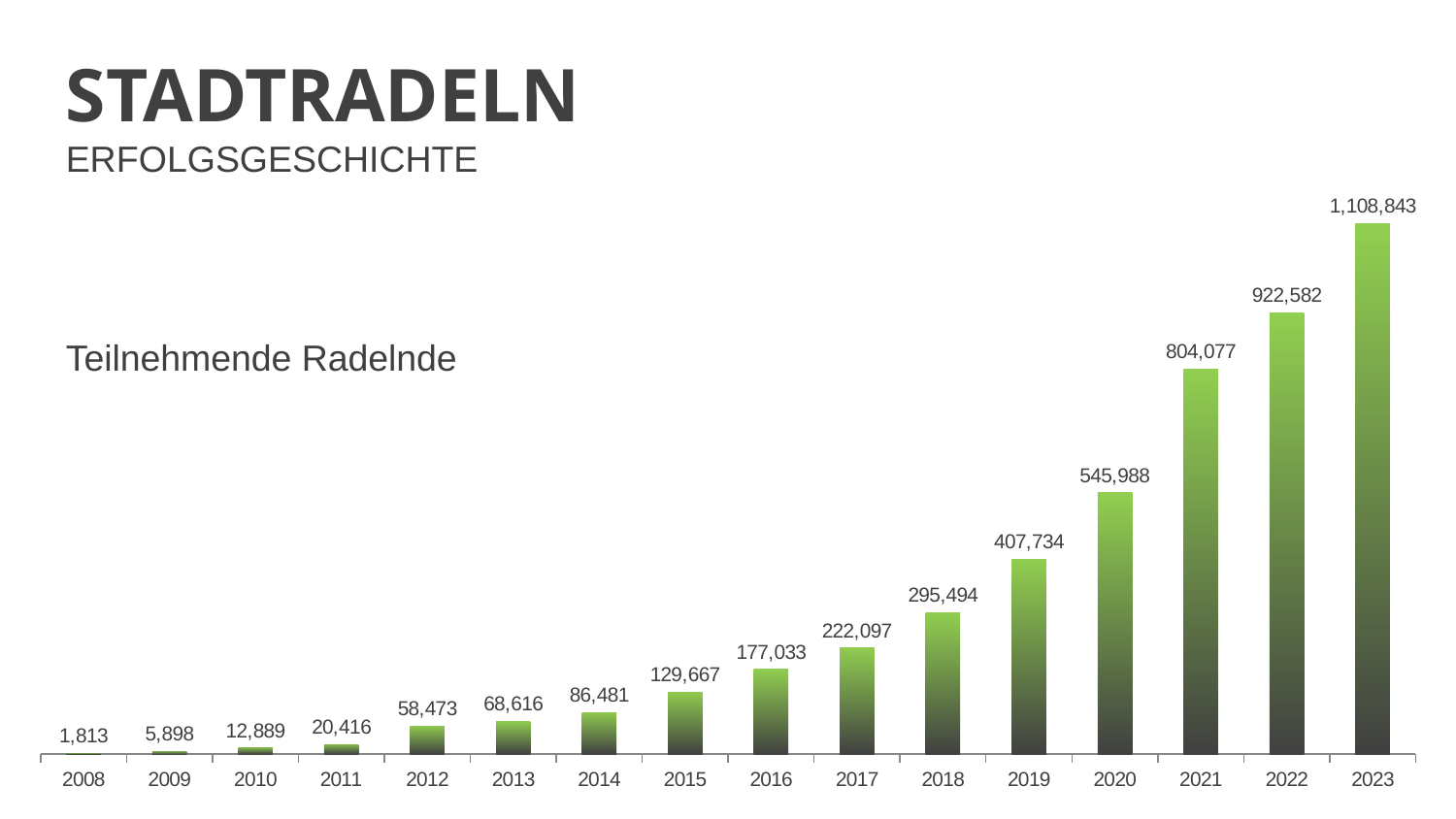
Which year has the highest value? 2023 What kind of chart is shown on the slide? Bar chart What is the value for 2023? 1,108,843 What is the difference between the values for 2020 and 2019? 138,254 Which year has the lowest value? 2008 What is the value for 2008? 1,813 What is the value for 2015? 129,667 Do the values rise or fall from 2008 to 2023? Rise Which is larger, the value for 2018 or the value for 2017? 2018 What is the value for 2020? 545,988 What is the difference between the values for 2023 and 2022? 186,261 How many years are shown on the x axis of the chart? 16